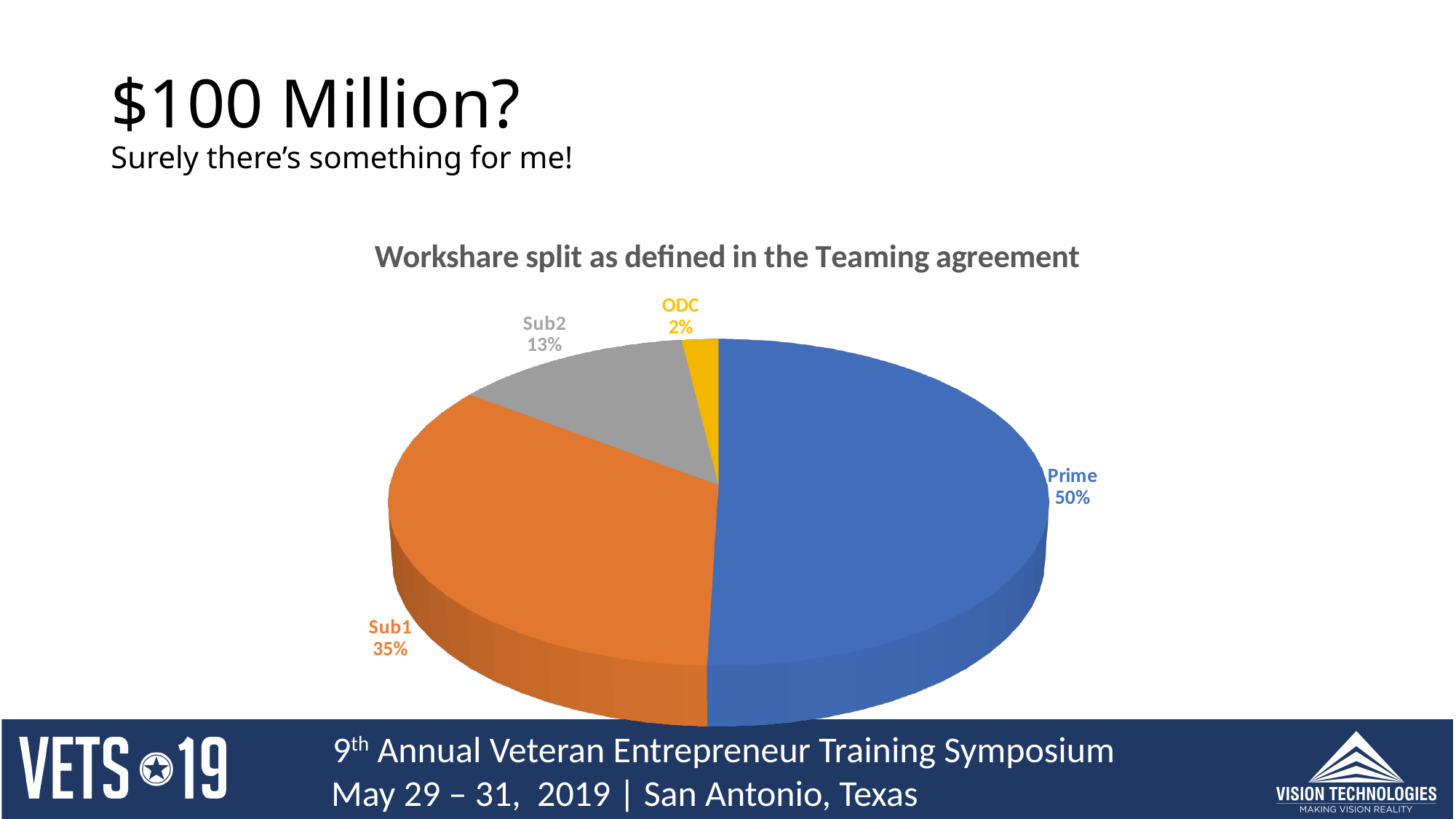
What colour is the Sub1 slice? Orange How many slices does the pie chart have? 4 Which is larger, the share for Sub2 or the share for ODC? Sub2 What kind of chart is shown on the slide? Pie chart What share of the workshare does Sub2 have? 13% What share of the workshare does ODC have? 2% What share of the workshare does Sub1 have? 35% Which category has the largest share of the pie? Prime Which category has the smallest share of the pie? ODC What share of the workshare does Prime have? 50% What is the title of the chart? Workshare split as defined in the Teaming agreement What is the difference in percentage points between Prime and Sub1? 15%